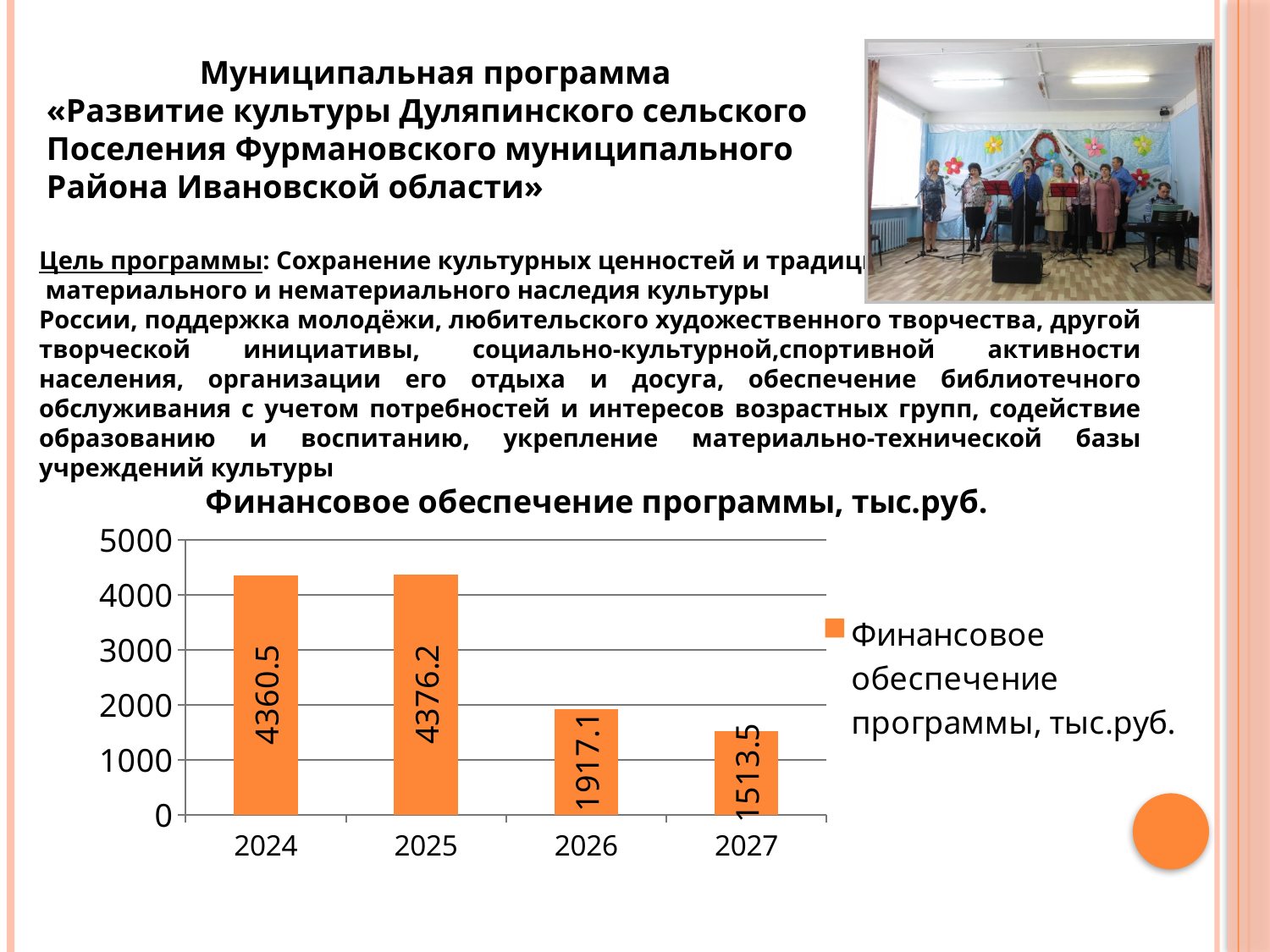
What is the value for 2026 in the chart? 1917.1 What kind of chart is shown on the slide? bar chart Is the value for 2026 greater or less than 2000? less What is the difference between the values for 2025 and 2024? 15.7 What is the value for 2027 in the chart? 1513.5 What is the value for 2024 in the chart? 4360.5 What is the title of the chart? Финансовое обеспечение программы, тыс.руб. Which year has the highest value in the chart? 2025 Which year has the lowest value in the chart? 2027 Which is larger, the value for 2026 or the value for 2027? 2026 How many years are shown on the x axis of the chart? 4 What is the difference between the values for 2026 and 2027? 403.6